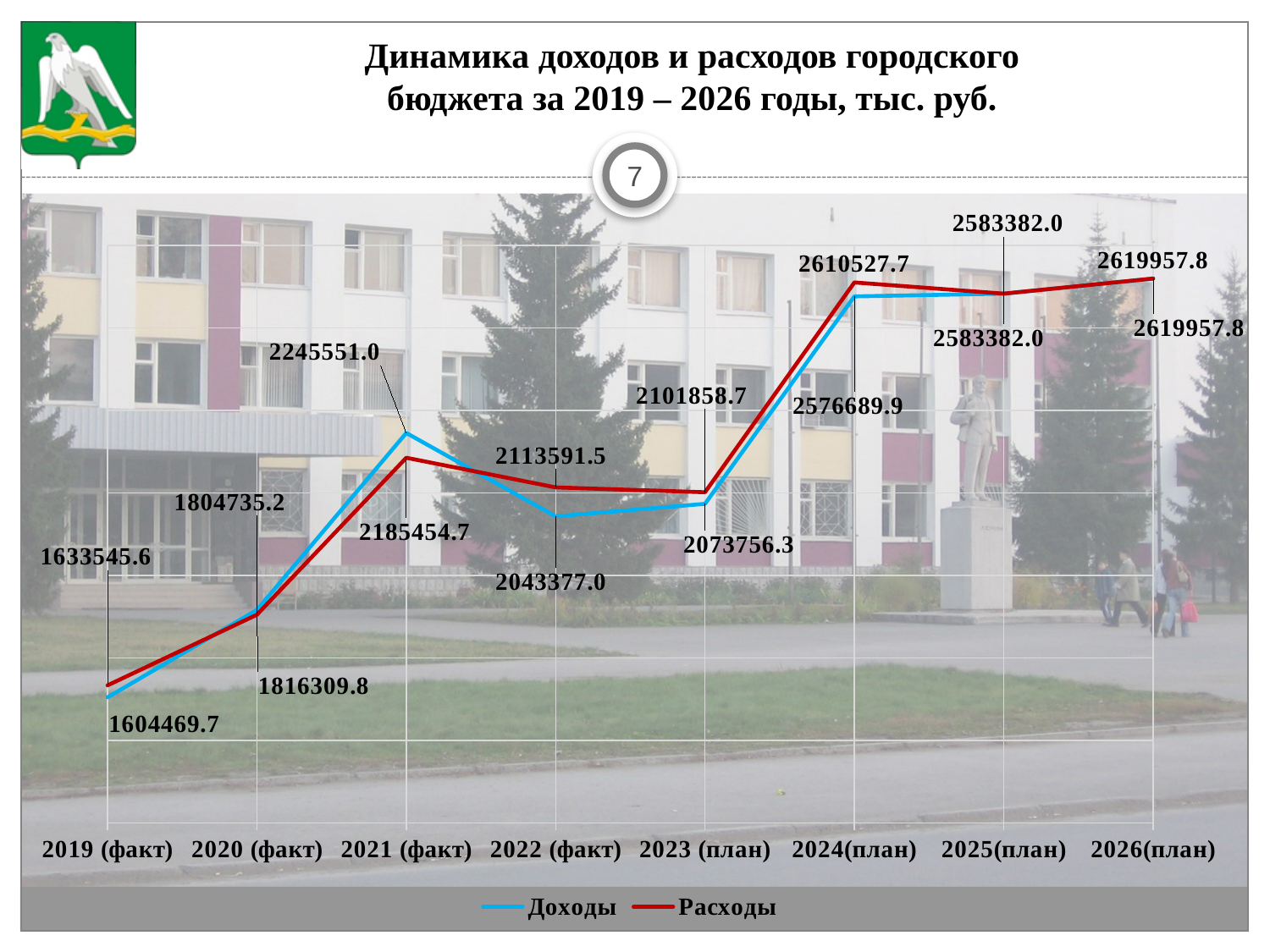
How many years (categories) are plotted along the x axis? 8 What is the difference between Расходы and Доходы in 2024(план)? 33837.8 What is the value of Доходы for 2019 (факт)? 1604469.7 In which year does Расходы reach its highest value? 2026(план) What is the value of Расходы for 2019 (факт)? 1633545.6 In which year is Доходы at its lowest? 2019 (факт) Which is larger in 2022 (факт), Доходы or Расходы? Расходы What type of chart is shown on the slide? line chart What is the value of Расходы for 2024(план)? 2610527.7 What is the value of Доходы for 2024(план)? 2576689.9 What is the value of Доходы for 2021 (факт)? 2245551.0 How many series does the legend list? 2